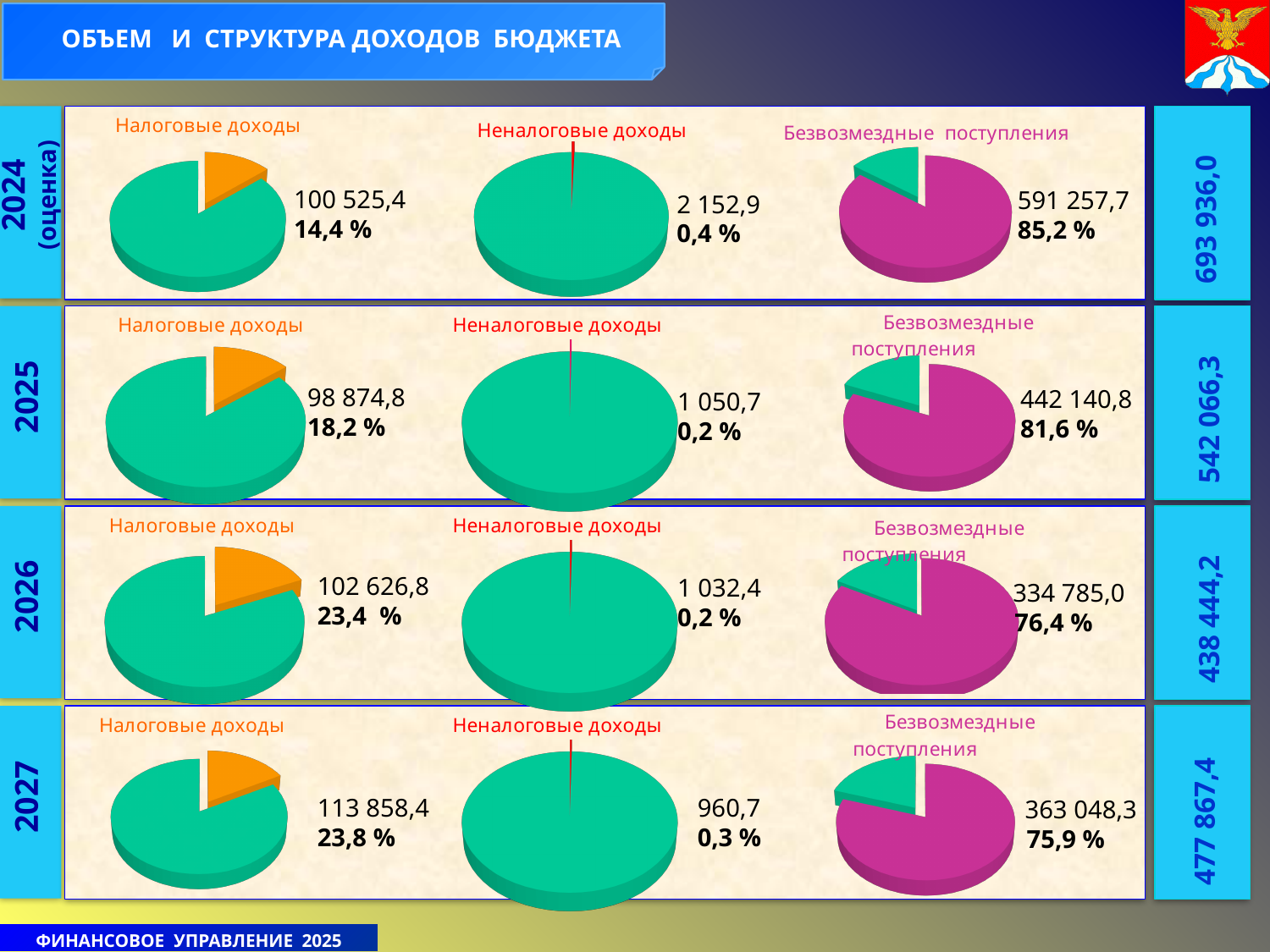
What kind of charts are shown on the slide? Pie charts Which is larger: the Налоговые доходы value for 2027 or the Налоговые доходы value for 2026? 2027 What is the difference between the Налоговые доходы value for 2027 (113 858,4) and for 2026 (102 626,8)? 11 231,6 Does the Безвозмездные поступления percentage rise or fall from 2024 to 2027? Fall In the 2026 row, what value is shown on the Безвозмездные поступления pie chart? 334 785,0 In the 2025 row, what percentage is shown on the Налоговые доходы pie chart? 18,2 % In the 2024 (оценка) row, what value is shown on the Налоговые доходы pie chart? 100 525,4 In the 2024 (оценка) row, what share does the Безвозмездные поступления pie chart show for its highlighted slice? 85,2 % In the 2027 row, what percentage is shown on the Неналоговые доходы pie chart? 0,3 % How many pie charts are shown on the slide? 12 In the 2025 row, what value is shown on the Неналоговые доходы pie chart? 1 050,7 In the 2027 row, what value is shown on the Налоговые доходы pie chart? 113 858,4